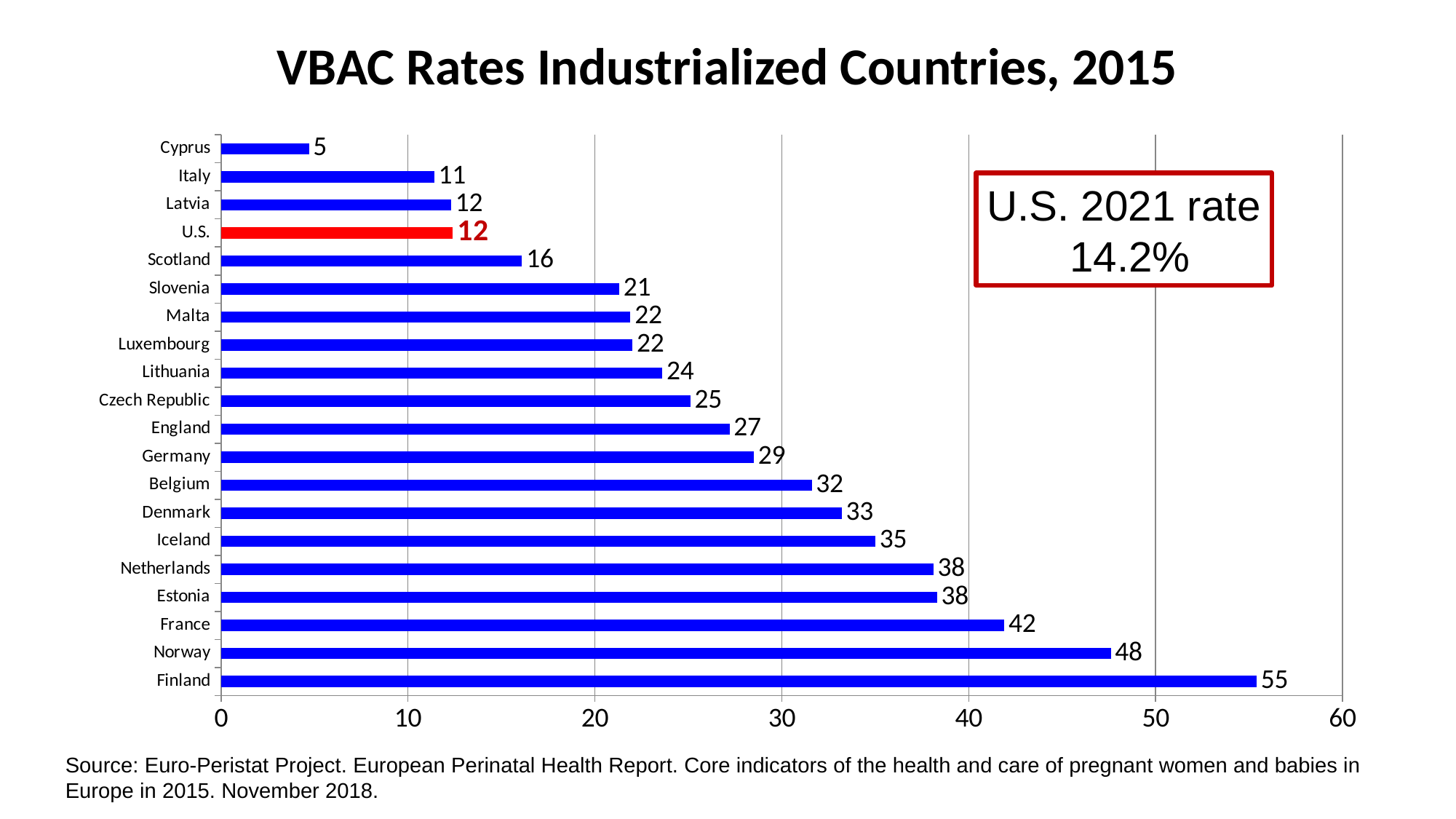
What is the VBAC rate shown for Finland? 55 What is the title of the chart? VBAC Rates Industrialized Countries, 2015 Which country has the highest VBAC rate on the chart? Finland How many countries are shown on the chart? 20 Which country has the lowest VBAC rate on the chart? Cyprus What kind of chart is shown on the slide? Bar chart What is the difference between the VBAC rates of Norway and France? 6 What is the VBAC rate shown for Germany? 29 What is the VBAC rate shown for the U.S.? 12 Which country's bar is coloured red instead of blue? U.S. Is the value for Iceland greater or less than 30? greater Which has a higher VBAC rate, Belgium or Scotland? Belgium